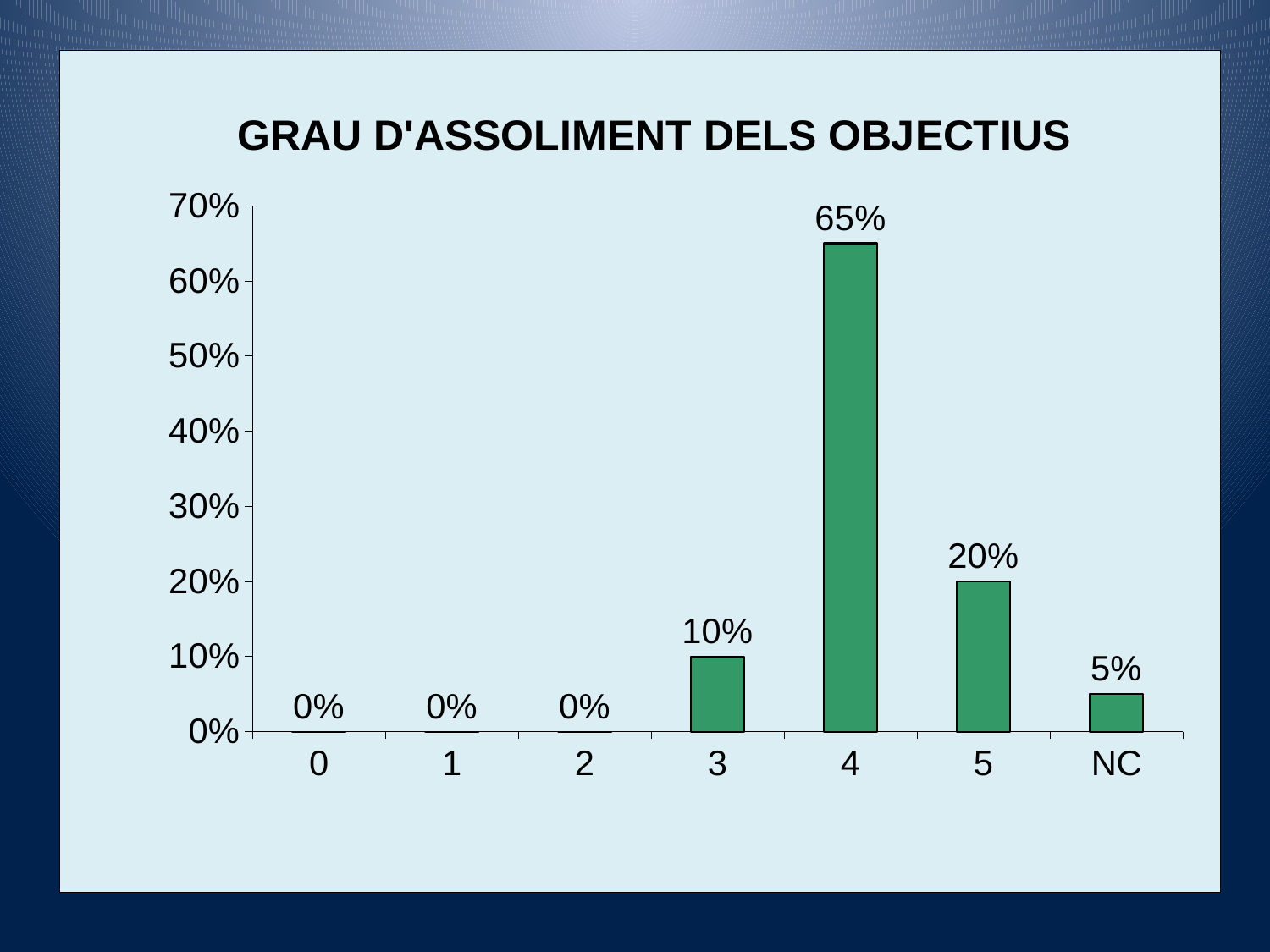
What is the value for category 5? 20% How many categories are shown on the x axis? 7 What is the difference between the values for categories 4 and 5? 45% How many categories have a value of 0%? 3 Which category has the highest value? 4 What is the value for category NC? 5% What is the title of the chart? GRAU D'ASSOLIMENT DELS OBJECTIUS Which is larger, the value for category 3 or the value for category NC? 3 Is the value for category 4 greater or less than 60%? greater What kind of chart is shown on the slide? bar chart What is the value for category 4? 65% What is the value for category 3? 10%